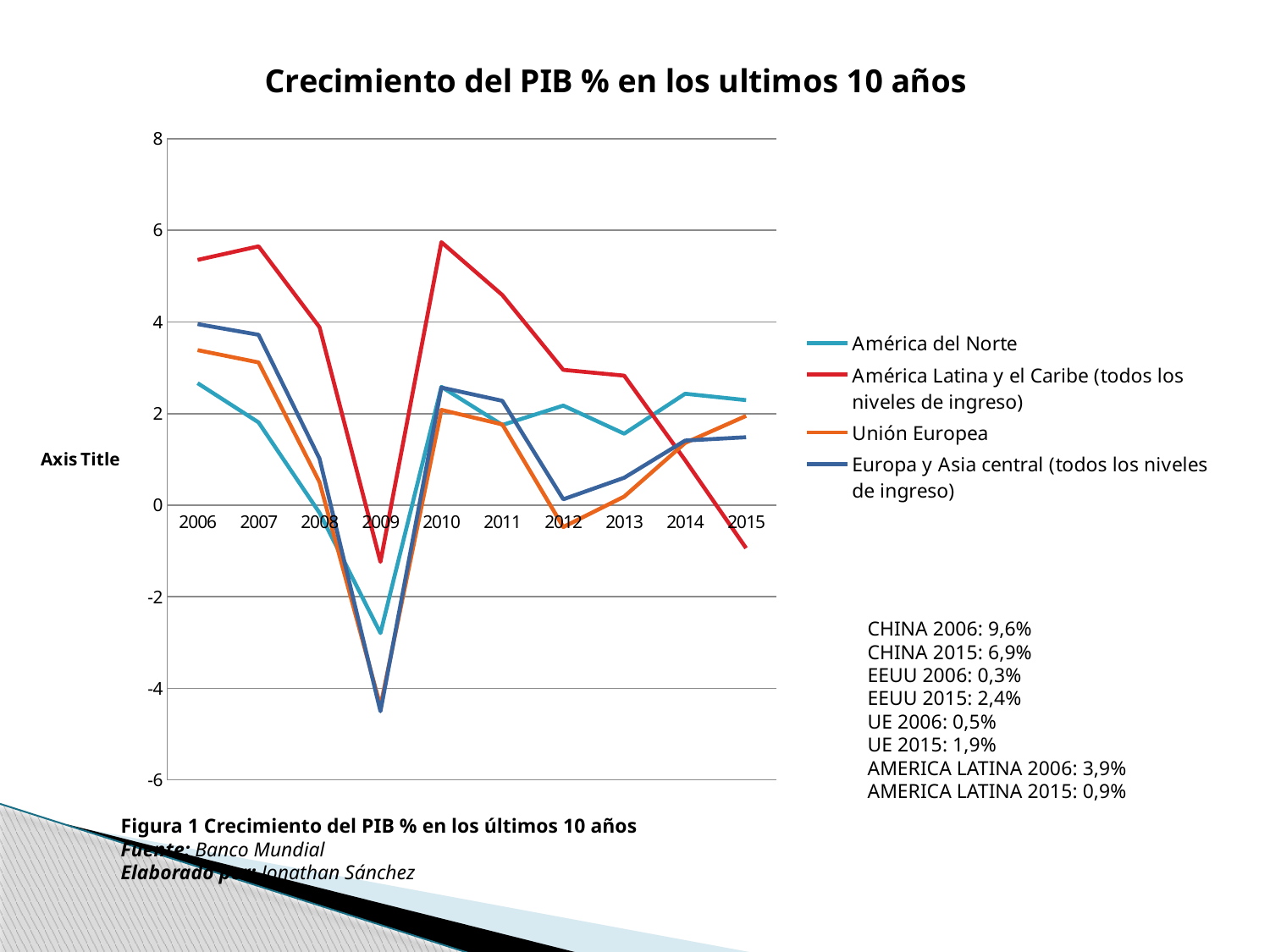
What is the title of the chart? Crecimiento del PIB % en los ultimos 10 años How many years are plotted along the x axis? 10 Which series has the lowest value in 2009? Europa y Asia central (todos los niveles de ingreso) Is the value for Europa y Asia central in 2009 greater or less than -4? less Is the value for América del Norte in 2009 greater or less than -2? less Is the value for América Latina y el Caribe in 2006 greater or less than 4? greater In which year does the América Latina y el Caribe line reach its lowest value? 2009 Does the América Latina y el Caribe line rise or fall from 2010 to 2015? fall What kind of chart is shown on the slide? line chart In 2015, which is larger: América del Norte or América Latina y el Caribe? América del Norte How many series does the legend list? 4